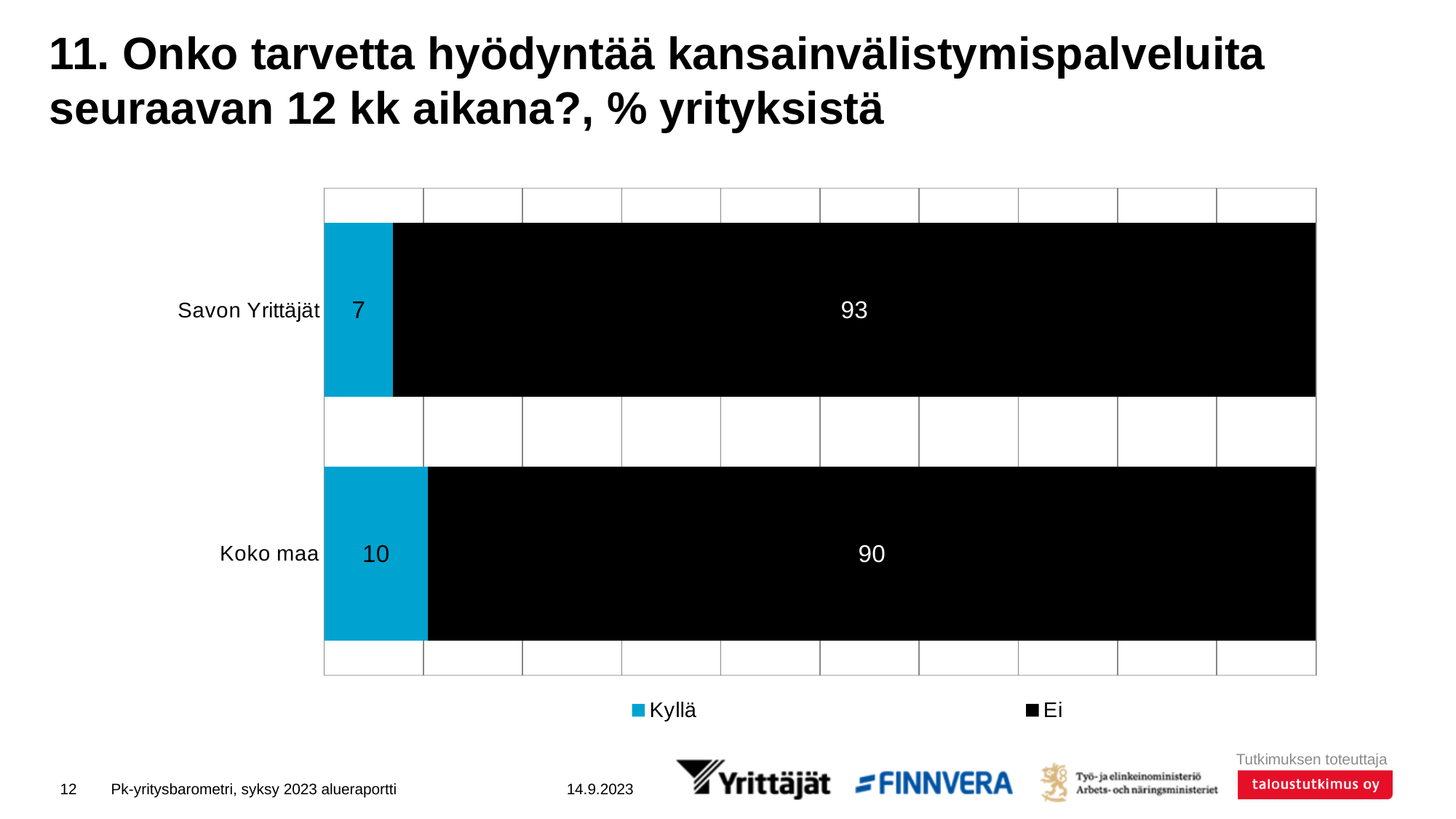
What is the value for Ei for Koko maa? 90 What kind of chart is shown on the slide? Stacked bar chart How many series does the legend list? 2 What is the total of the stacked bar for Savon Yrittäjät? 100 What is the difference between the Kyllä values for Koko maa and Savon Yrittäjät? 3 What is the difference between the Ei values for Savon Yrittäjät and Koko maa? 3 Which category has the higher Kyllä value, Savon Yrittäjät or Koko maa? Koko maa How many categories are shown on the chart? 2 What is the value for Kyllä for Savon Yrittäjät? 7 What is the value for Ei for Savon Yrittäjät? 93 Which category has the highest Ei value? Savon Yrittäjät What is the value for Kyllä for Koko maa? 10